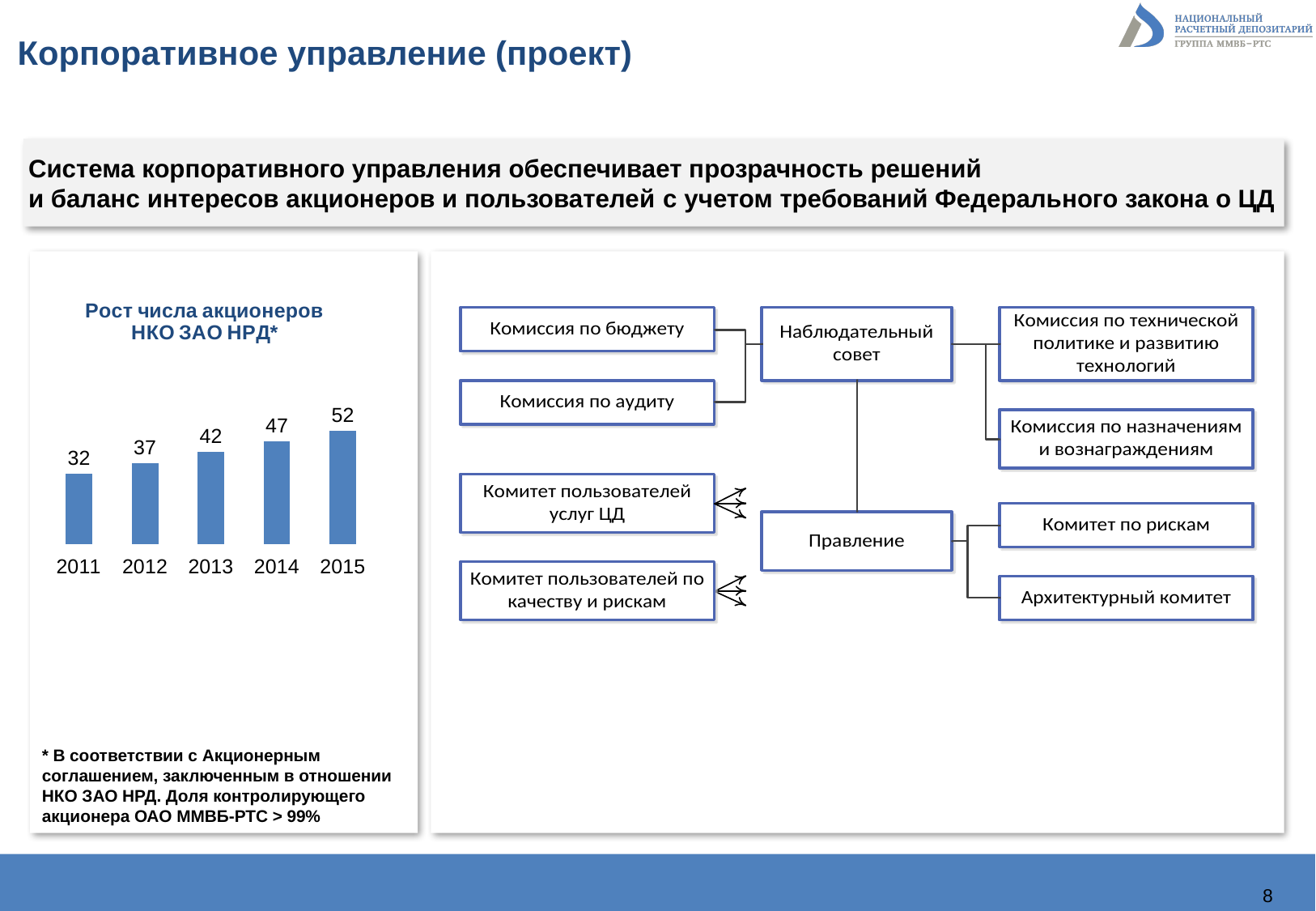
What kind of chart is 'Рост числа акционеров НКО ЗАО НРД*'? bar chart What is the difference between the values for 2015 and 2011 in the chart 'Рост числа акционеров НКО ЗАО НРД*'? 20 In the chart 'Рост числа акционеров НКО ЗАО НРД*', which is larger: the value for 2012 or the value for 2014? 2014 What is the value for 2013 in the chart 'Рост числа акционеров НКО ЗАО НРД*'? 42 What is the value for 2015 in the chart 'Рост числа акционеров НКО ЗАО НРД*'? 52 What is the title of the bar chart on the left of the slide? Рост числа акционеров НКО ЗАО НРД* Do the values rise or fall from 2011 to 2015 in the chart 'Рост числа акционеров НКО ЗАО НРД*'? rise Which year has the highest value in the chart 'Рост числа акционеров НКО ЗАО НРД*'? 2015 Which year has the lowest value in the chart 'Рост числа акционеров НКО ЗАО НРД*'? 2011 What is the value for 2011 in the chart 'Рост числа акционеров НКО ЗАО НРД*'? 32 What is the difference between the values for 2014 and 2012 in the chart 'Рост числа акционеров НКО ЗАО НРД*'? 10 How many years are shown in the chart 'Рост числа акционеров НКО ЗАО НРД*'? 5